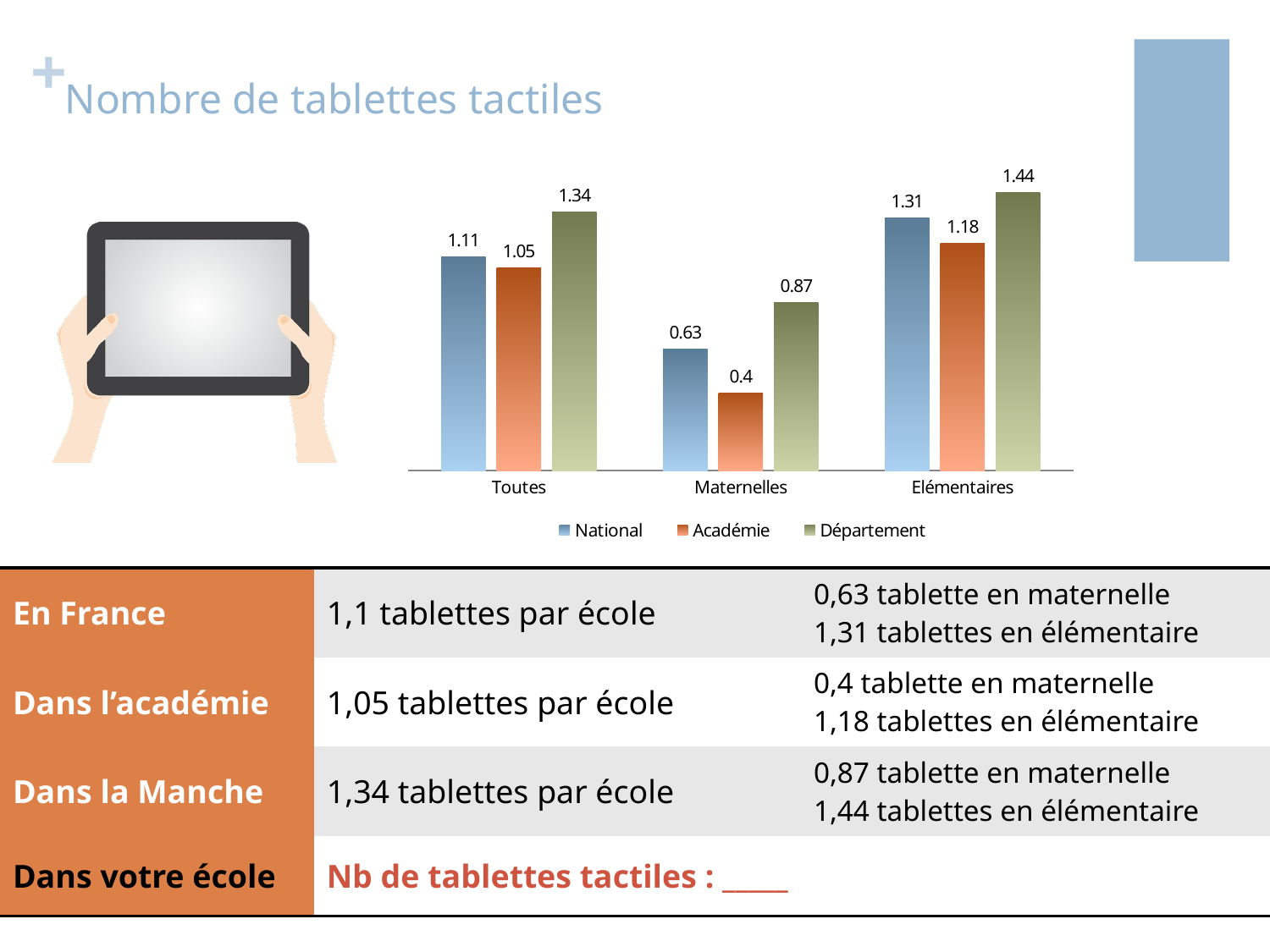
What is the difference between the Département and National values for Toutes? 0.23 Which series is shown in orange in the legend? Académie What is the difference between the Département and Académie values for Maternelles? 0.47 How many series does the legend list? 3 What is the Académie value for Toutes? 1.05 What is the National value for Maternelles? 0.63 Which is larger for Elémentaires: the National value or the Académie value? National Which series has the highest value for Maternelles? Département Which category has the lowest Académie value? Maternelles How many categories are shown on the x axis? 3 What is the Département value for Elémentaires? 1.44 What kind of chart is shown on the slide? Bar chart